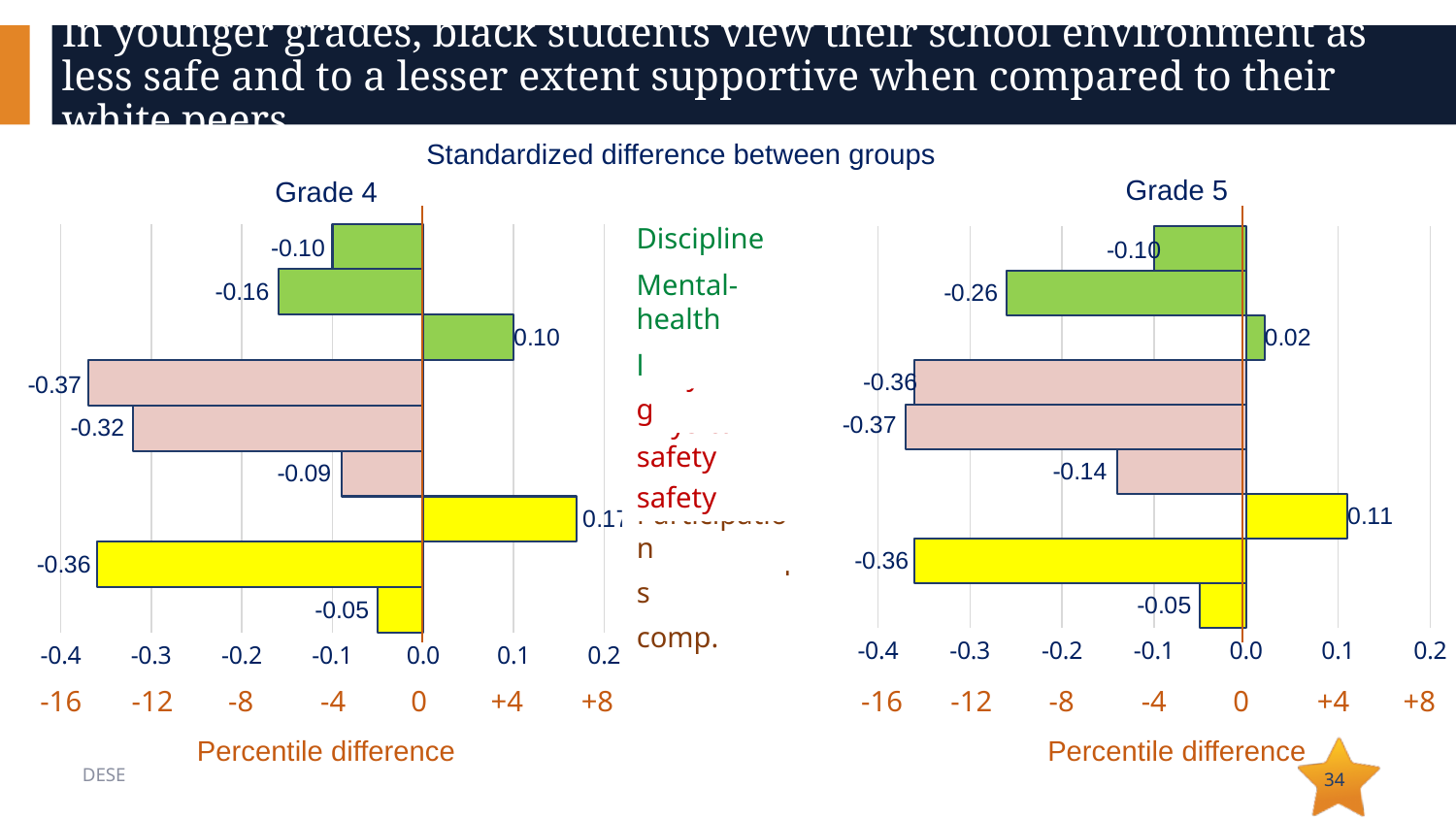
What is the shared title above the two charts? Standardized difference between groups In the Grade 4 chart, what is the value for Mental-health? -0.16 How many bars are plotted in the Grade 4 chart? 9 In the Grade 4 chart, what is the difference between the Discipline value and the Mental-health value? 0.06 In the Grade 4 chart, what is the highest value shown on any bar? 0.17 In the Grade 5 chart, which has the larger (less negative) value, Discipline or Mental-health? Discipline In the Grade 4 chart, what is the lowest value shown on any bar? -0.37 In the Grade 5 chart, what is the value for Mental-health? -0.26 In the Grade 5 chart, what is the value for Discipline? -0.10 In the Grade 4 chart, what is the value for Discipline? -0.10 What type of chart is the Grade 5 chart? Bar chart In the Grade 5 chart, what is the highest value shown on any bar? 0.11